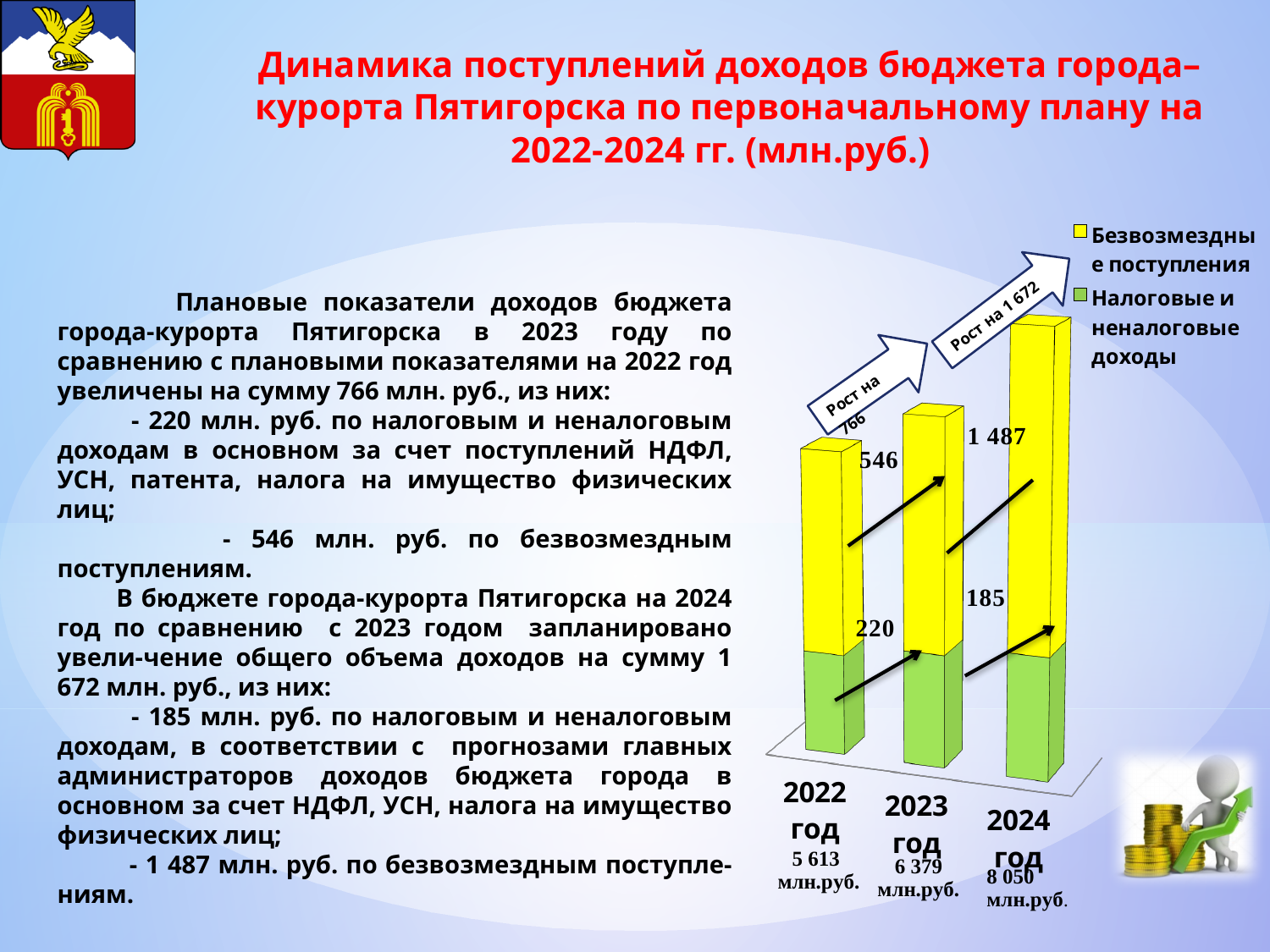
Which year has the highest total planned revenue? 2024 год What total budget revenue is printed under the 2022 bar? 5 613 млн.руб. How many years (categories) are shown on the x axis of the chart? 3 Do the total revenues rise or fall from 2022 to 2024? Rise How many series does the chart legend list? 2 What increase in безвозмездные поступления between 2022 and 2023 is labelled on the chart? 546 By how much does the total for 2023 (6 379) exceed the total for 2022 (5 613)? 766 Which year has the lowest total planned revenue? 2022 год What kind of chart is shown on the slide? Stacked bar chart What total budget revenue is printed under the 2024 bar? 8 050 млн.руб. Which colour represents 'Налоговые и неналоговые доходы' in the legend? Green Which is larger, the total for 2023 or the total for 2024? 2024